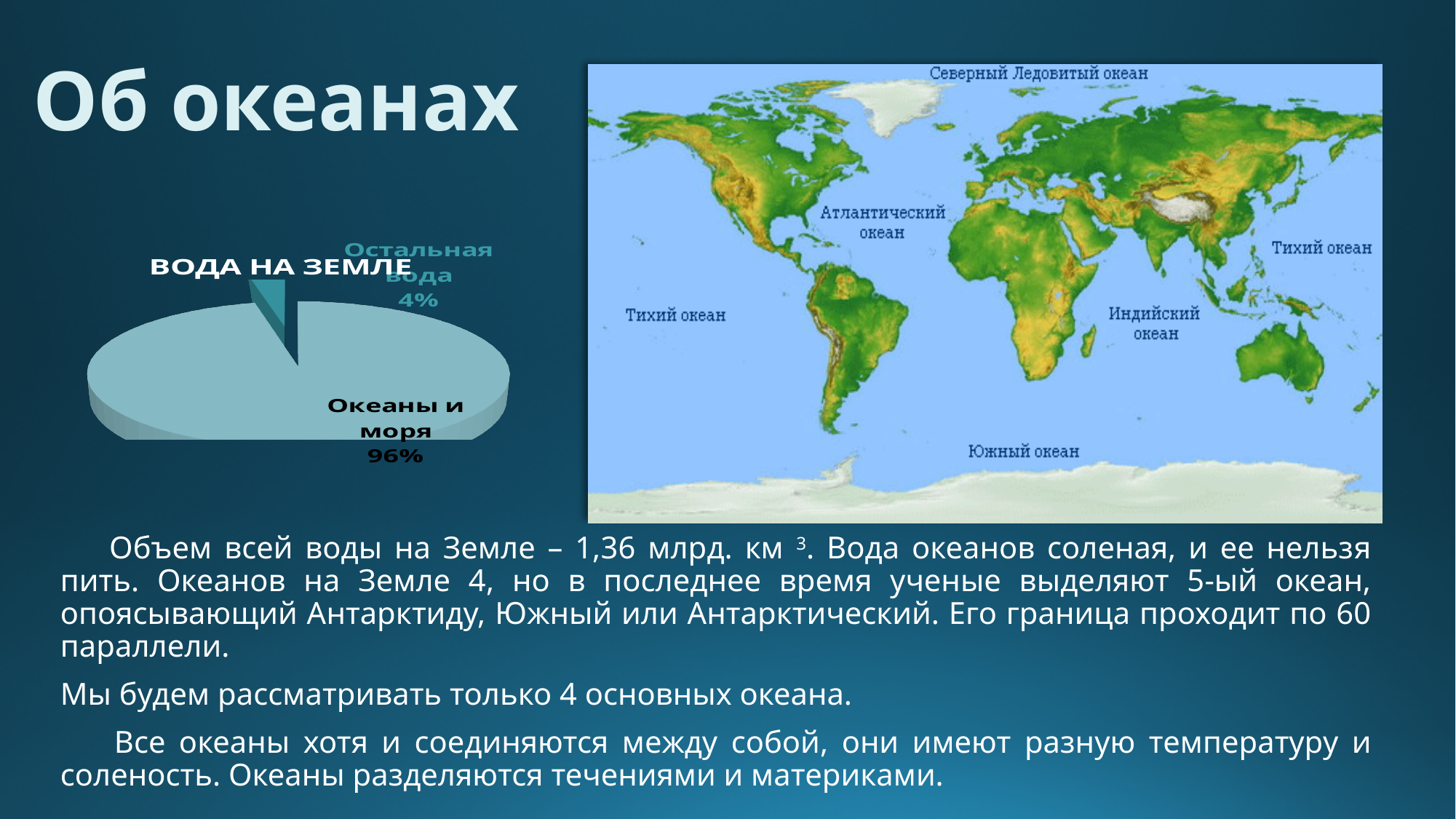
Which is larger in the pie chart: "Океаны и моря" or "Остальная вода"? Океаны и моря By how many percentage points does "Океаны и моря" exceed "Остальная вода" in the pie chart? 92 Which slice of the pie chart is the largest? Океаны и моря What share of the pie chart is labelled "Океаны и моря"? 96% What kind of chart is shown on the slide? Pie chart Which slice of the pie chart is the smallest? Остальная вода What share of the pie chart is labelled "Остальная вода"? 4% How many slices does the pie chart have? 2 What is the title of the pie chart? ВОДА НА ЗЕМЛЕ Is the share for "Остальная вода" in the pie chart greater or less than 50%? less What is the total of the two slices shown in the pie chart? 100%